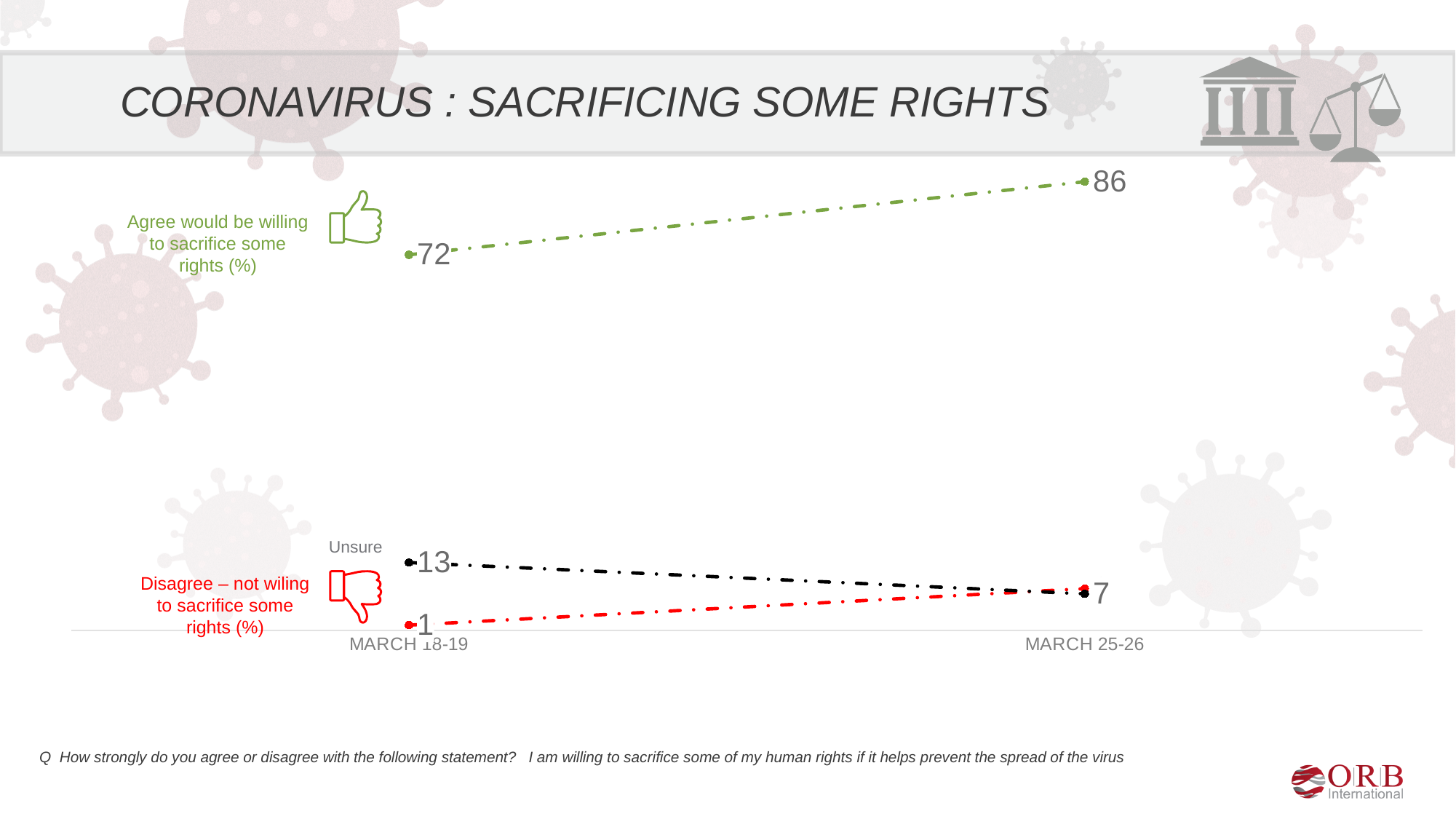
What percentage agreed they would be willing to sacrifice some rights in the March 25-26 wave? 86 What percentage disagreed (not willing to sacrifice some rights) in the March 18-19 wave? 1 Which response had the lowest percentage in the March 18-19 wave? Disagree – not willing to sacrifice some rights By how many points did the Agree percentage change between March 18-19 and March 25-26? 14 Did the Unsure percentage rise or fall from March 18-19 to March 25-26? fall Did the Agree percentage rise or fall from March 18-19 to March 25-26? rise Which response had the highest percentage in the March 18-19 wave? Agree would be willing to sacrifice some rights What is the difference between the Unsure and Disagree percentages in the March 18-19 wave? 12 How many survey waves (time points) are plotted on the x axis? 2 What was the Unsure percentage in the March 18-19 wave? 13 What kind of chart is shown on the slide? line chart What percentage agreed they would be willing to sacrifice some rights in the March 18-19 wave? 72